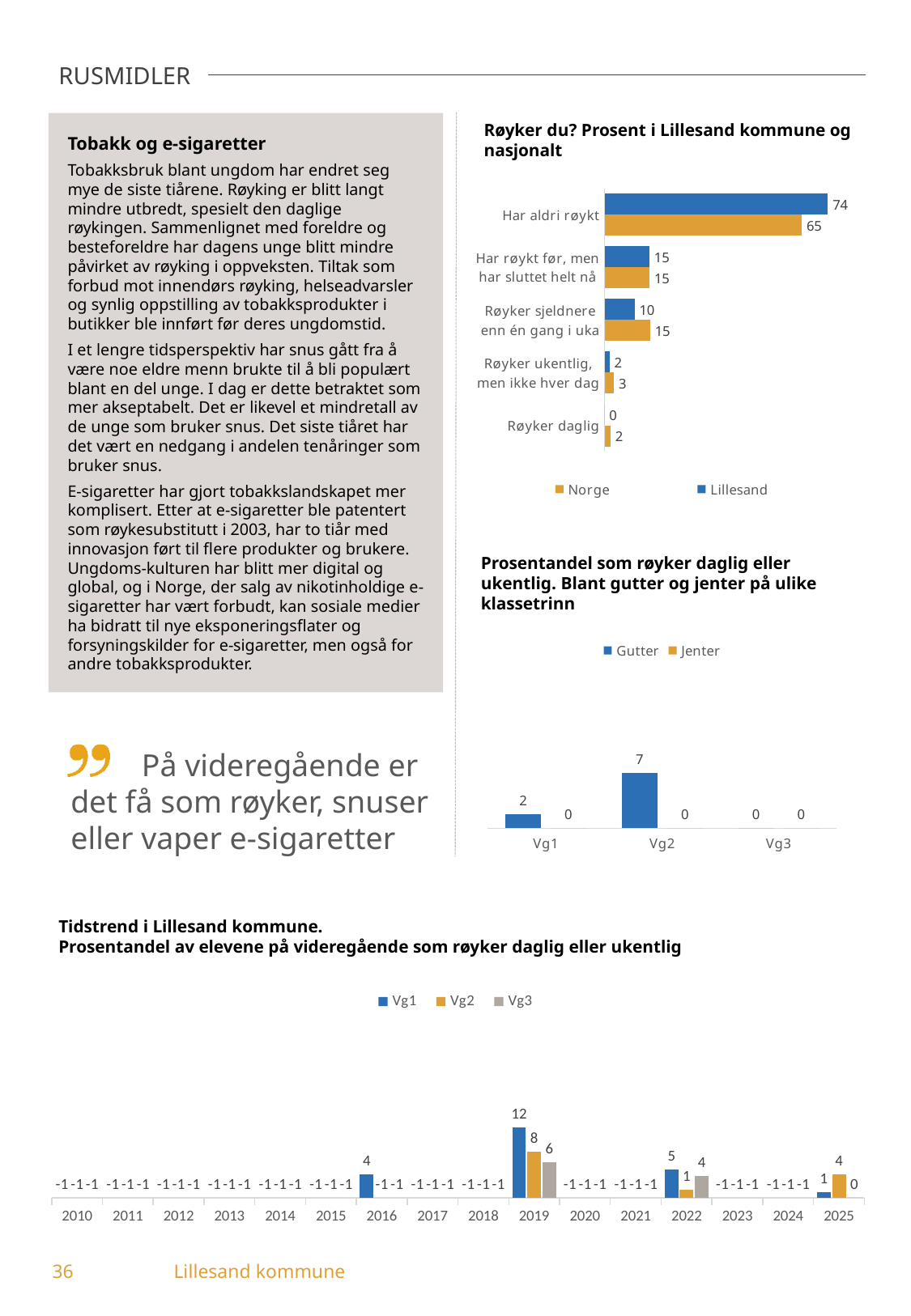
In the chart 'Tidstrend i Lillesand kommune', what is the value for Vg1 in 2019? 12 In the chart 'Røyker du? Prosent i Lillesand kommune og nasjonalt', what is the value for Norge for 'Røyker sjeldnere enn én gang i uka'? 15 In the chart 'Prosentandel som røyker daglig eller ukentlig', how many class levels are shown on the x axis? 3 In the chart 'Røyker du? Prosent i Lillesand kommune og nasjonalt', what is the difference between Lillesand and Norge for 'Har aldri røykt'? 9 In the chart 'Røyker du? Prosent i Lillesand kommune og nasjonalt', which category has the highest value for Lillesand? Har aldri røykt In the chart 'Tidstrend i Lillesand kommune', what is the value for Vg2 in 2025? 4 In the chart 'Røyker du? Prosent i Lillesand kommune og nasjonalt', how many series does the legend list? 2 In the chart 'Røyker du? Prosent i Lillesand kommune og nasjonalt', what kind of chart is shown? Bar chart In the chart 'Prosentandel som røyker daglig eller ukentlig', what is the value for Gutter at Vg2? 7 In the chart 'Prosentandel som røyker daglig eller ukentlig', which is larger at Vg1: Gutter or Jenter? Gutter In the chart 'Tidstrend i Lillesand kommune', what is the difference between Vg1 and Vg3 in 2022? 1 In the chart 'Røyker du? Prosent i Lillesand kommune og nasjonalt', what is the value for Lillesand for 'Har aldri røykt'? 74